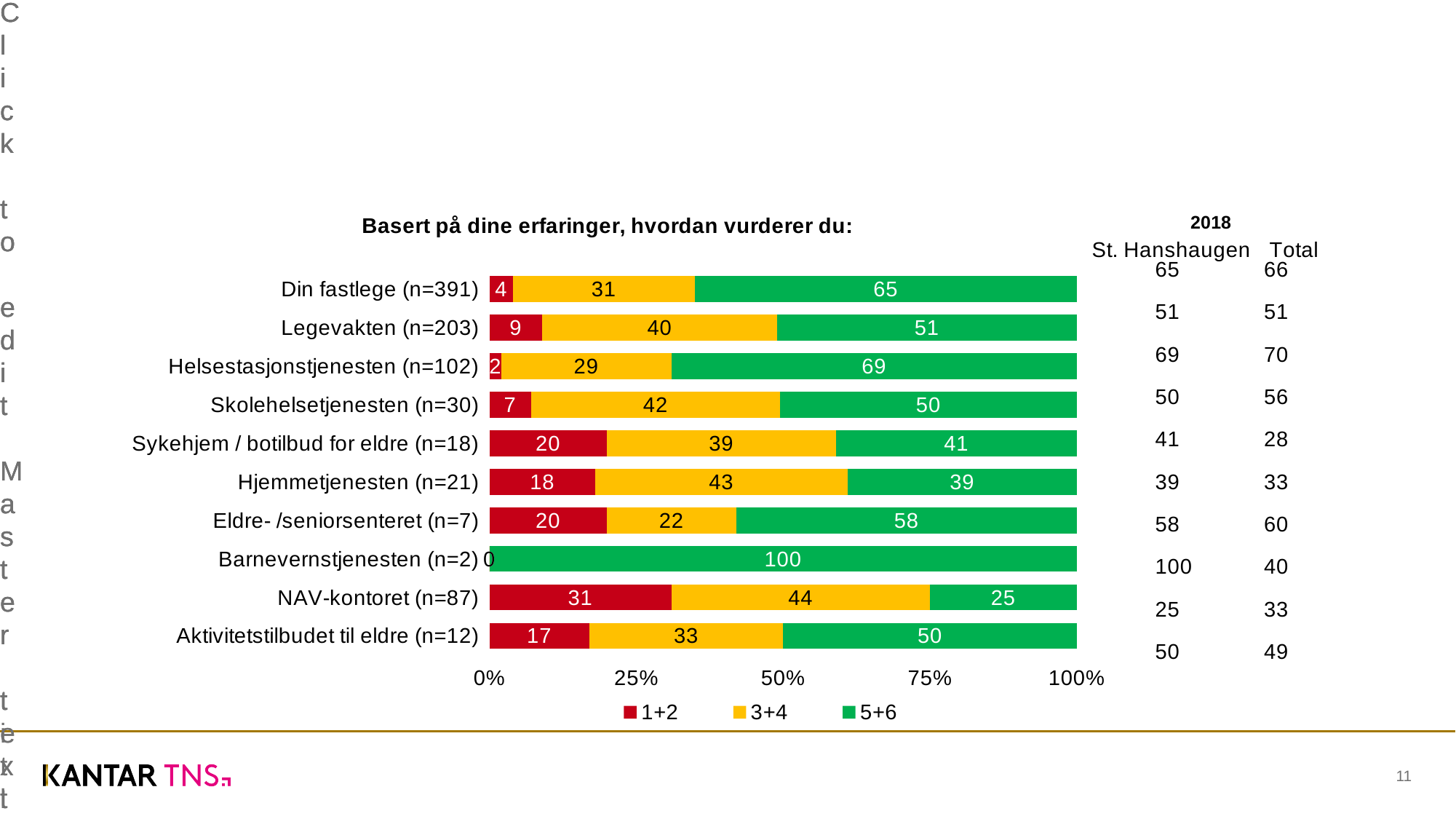
What is the value of the 3+4 series for Legevakten (n=203)? 40 Which is larger: the 5+6 value for Sykehjem / botilbud for eldre (n=18) or for Eldre- /seniorsenteret (n=7)? Eldre- /seniorsenteret (n=7) What is the difference between the 5+6 value and the 1+2 value for Din fastlege (n=391)? 61 What is the value of the 1+2 series for NAV-kontoret (n=87)? 31 What kind of chart is shown on the slide? Stacked bar chart How many series does the legend list? 3 What is the value of the 5+6 series for Din fastlege (n=391)? 65 Which category has the highest value in the 5+6 series? Barnevernstjenesten (n=2) Which category has the highest value in the 1+2 series? NAV-kontoret (n=87) How many categories are shown on the chart? 10 What is the title of the chart? Basert på dine erfaringer, hvordan vurderer du: Which category has the lowest value in the 5+6 series? NAV-kontoret (n=87)